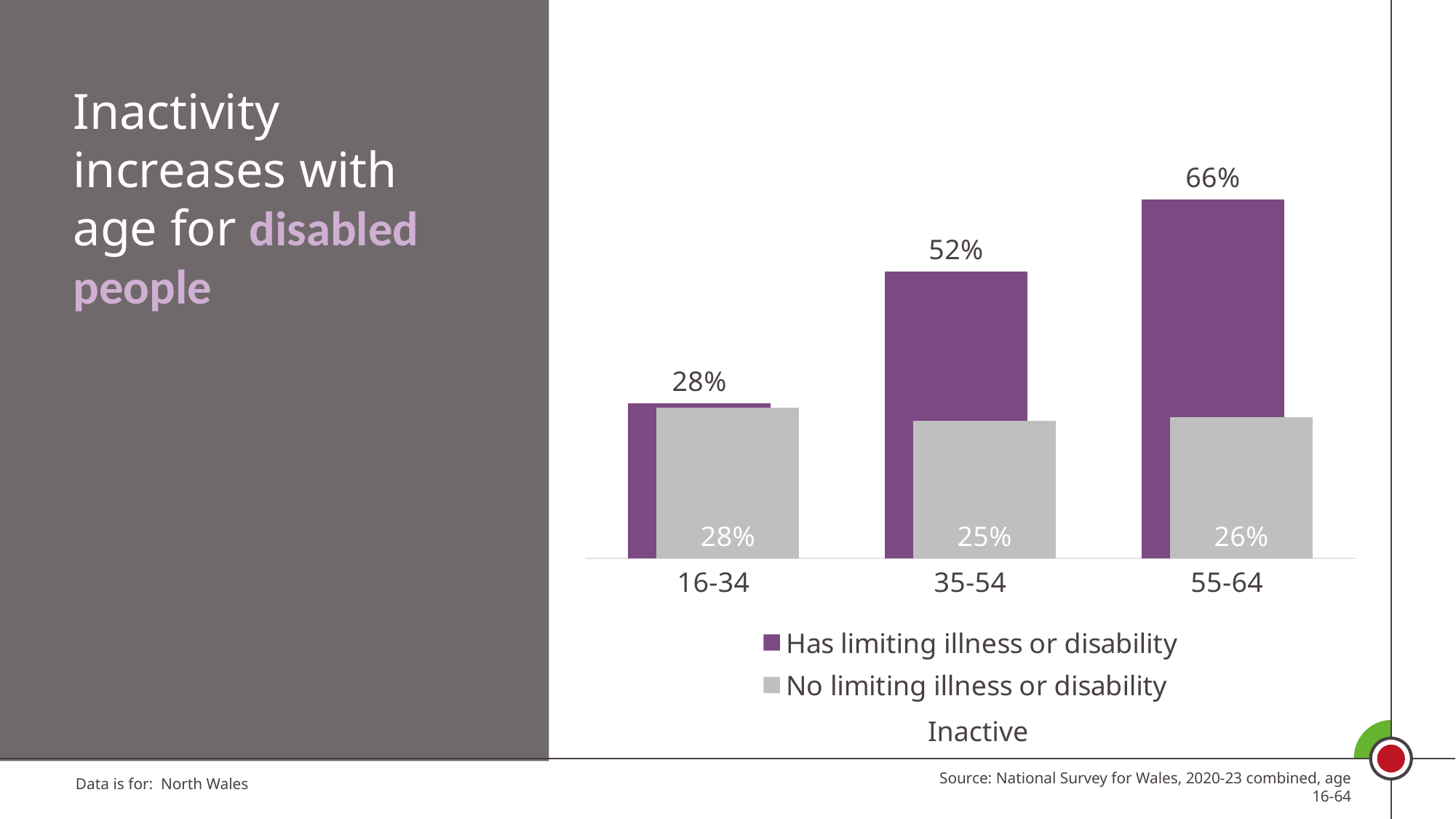
How many age groups are shown on the chart? 3 Which age group has the highest inactivity rate among people with a limiting illness or disability? 55-64 What is the difference in inactivity rate between the 35-54 and 16-34 age groups for people with a limiting illness or disability? 24 percentage points In the 35-54 age group, which is larger: the inactivity rate for people with a limiting illness or disability, or for those without? Has limiting illness or disability What is the inactivity rate for people aged 55-64 who have a limiting illness or disability? 66% What is the inactivity rate for people aged 16-34 who have a limiting illness or disability? 28% What kind of chart is shown on the slide? Bar chart Which age group has the lowest inactivity rate among people with no limiting illness or disability? 35-54 What is the difference between the inactivity rates of people with and without a limiting illness or disability in the 55-64 age group? 40 percentage points What is the inactivity rate for people aged 35-54 with no limiting illness or disability? 25% How many series does the legend list? 2 Do the inactivity rates for people with a limiting illness or disability rise or fall as age increases? Rise